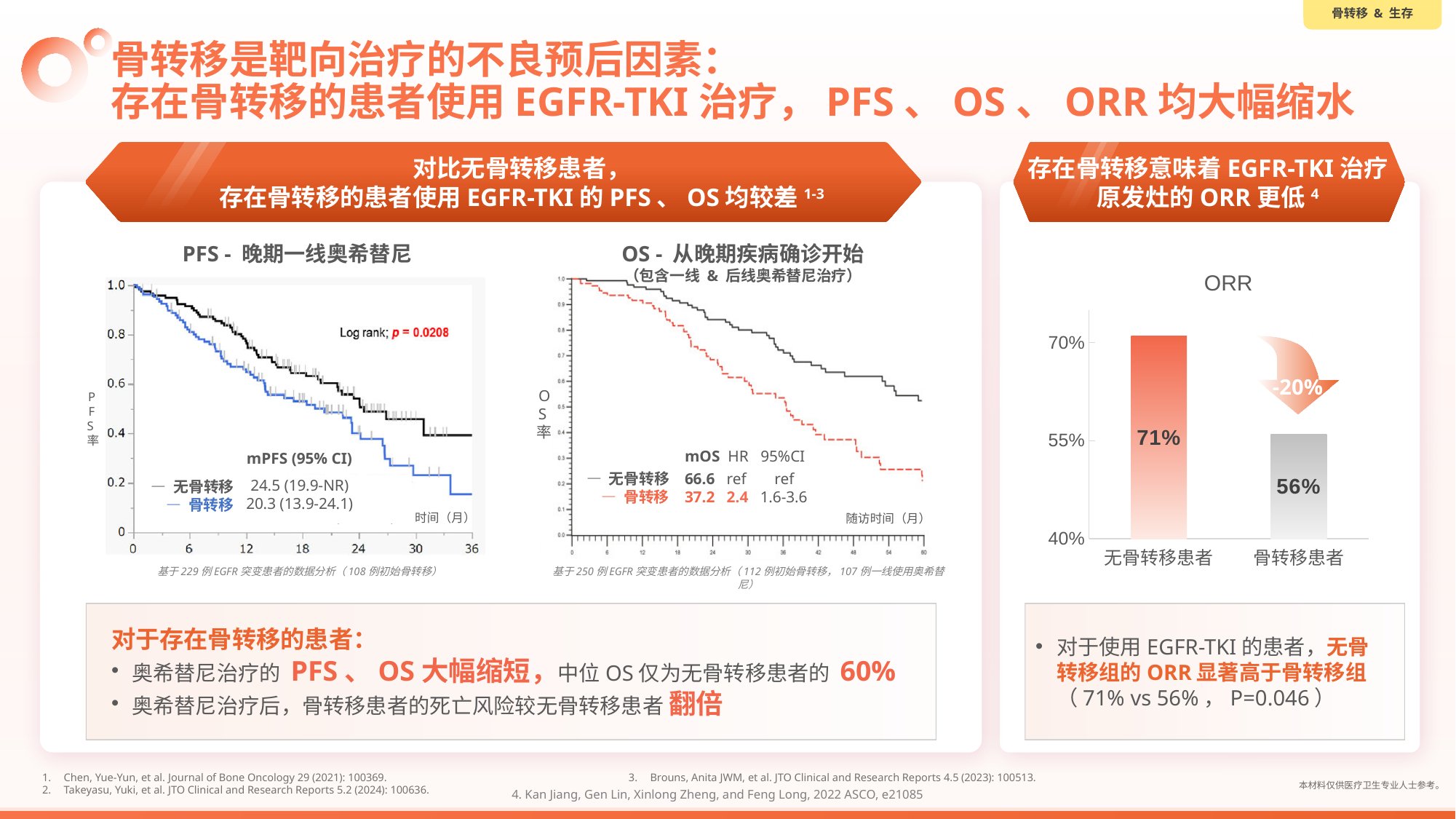
In the OS chart (OS - 从晚期疾病确诊开始), what is the mOS for the 无骨转移 group? 66.6 In the ORR chart, which group has the higher ORR? 无骨转移患者 In the PFS chart (PFS - 晚期一线奥希替尼), what is the log rank p value shown? p = 0.0208 In the ORR chart, is the value for 骨转移患者 greater or less than 70%? less In the ORR chart, what is the ORR for 骨转移患者? 56% In the PFS chart (PFS - 晚期一线奥希替尼), what is the mPFS for the 骨转移 group? 20.3 (13.9-24.1) In the ORR chart, what is the difference in ORR between 无骨转移患者 and 骨转移患者? 15% In the PFS chart (PFS - 晚期一线奥希替尼), how many series does the legend list? 2 In the ORR chart, how many patient groups are plotted? 2 What kind of chart is the ORR chart? Bar chart In the OS chart (OS - 从晚期疾病确诊开始), what is the HR for the 骨转移 group? 2.4 In the ORR chart, what is the ORR for 无骨转移患者? 71%